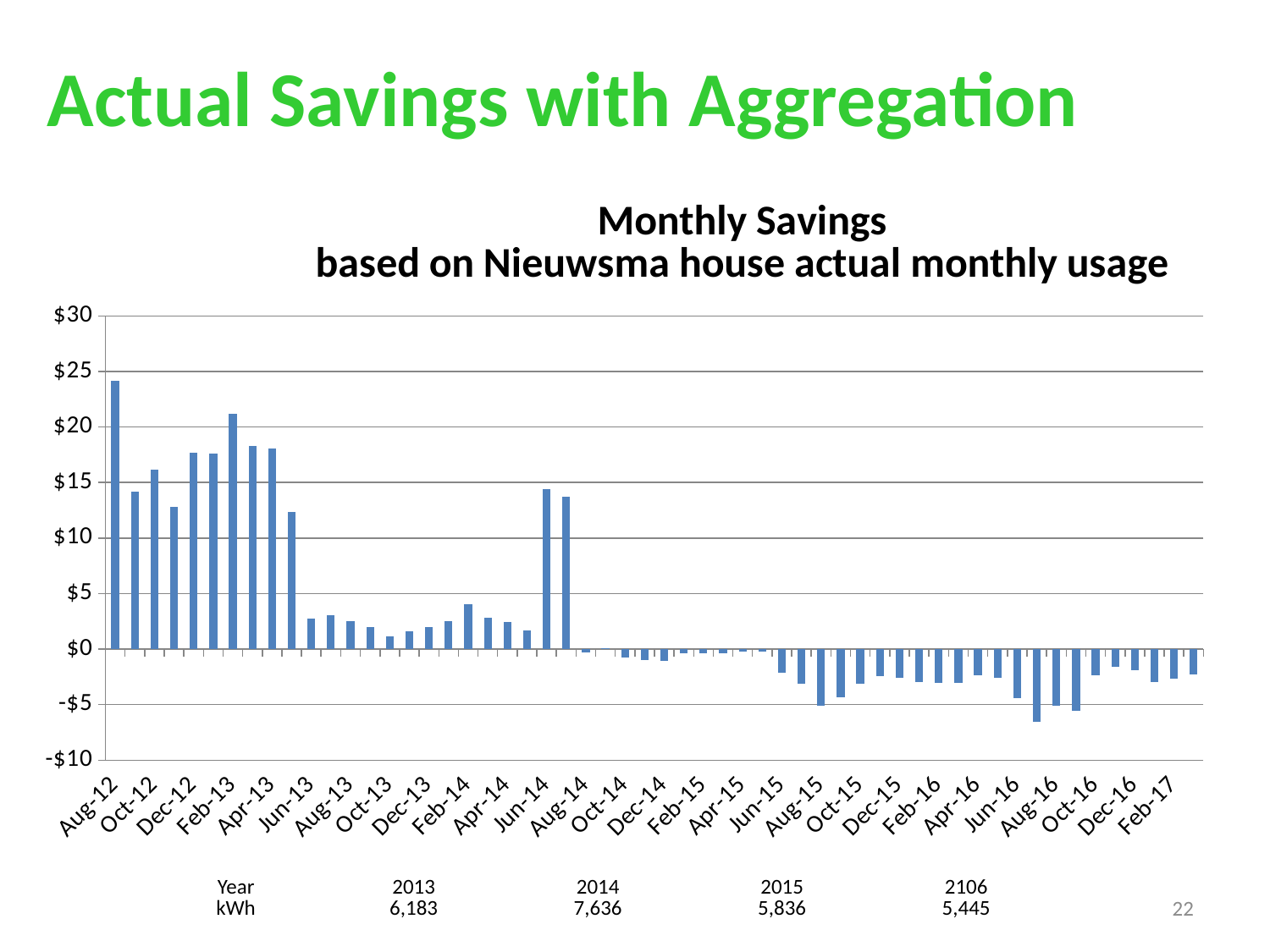
What is the title of the chart? Monthly Savings based on Nieuwsma house actual monthly usage What kind of chart is shown on the slide? bar chart Do the monthly savings generally rise or fall from Aug-12 to Feb-17? fall Is the value for Jun-14 greater or less than $10? greater Which is larger, the value for Aug-12 or the value for Feb-13? Aug-12 Which month has the highest monthly savings? Aug-12 Is the value for Feb-14 greater or less than $5? less Which is larger, the value for Jun-13 or the value for Jun-14? Jun-14 Is the value for Dec-12 greater or less than $15? greater What is the highest value shown on the y axis? $30